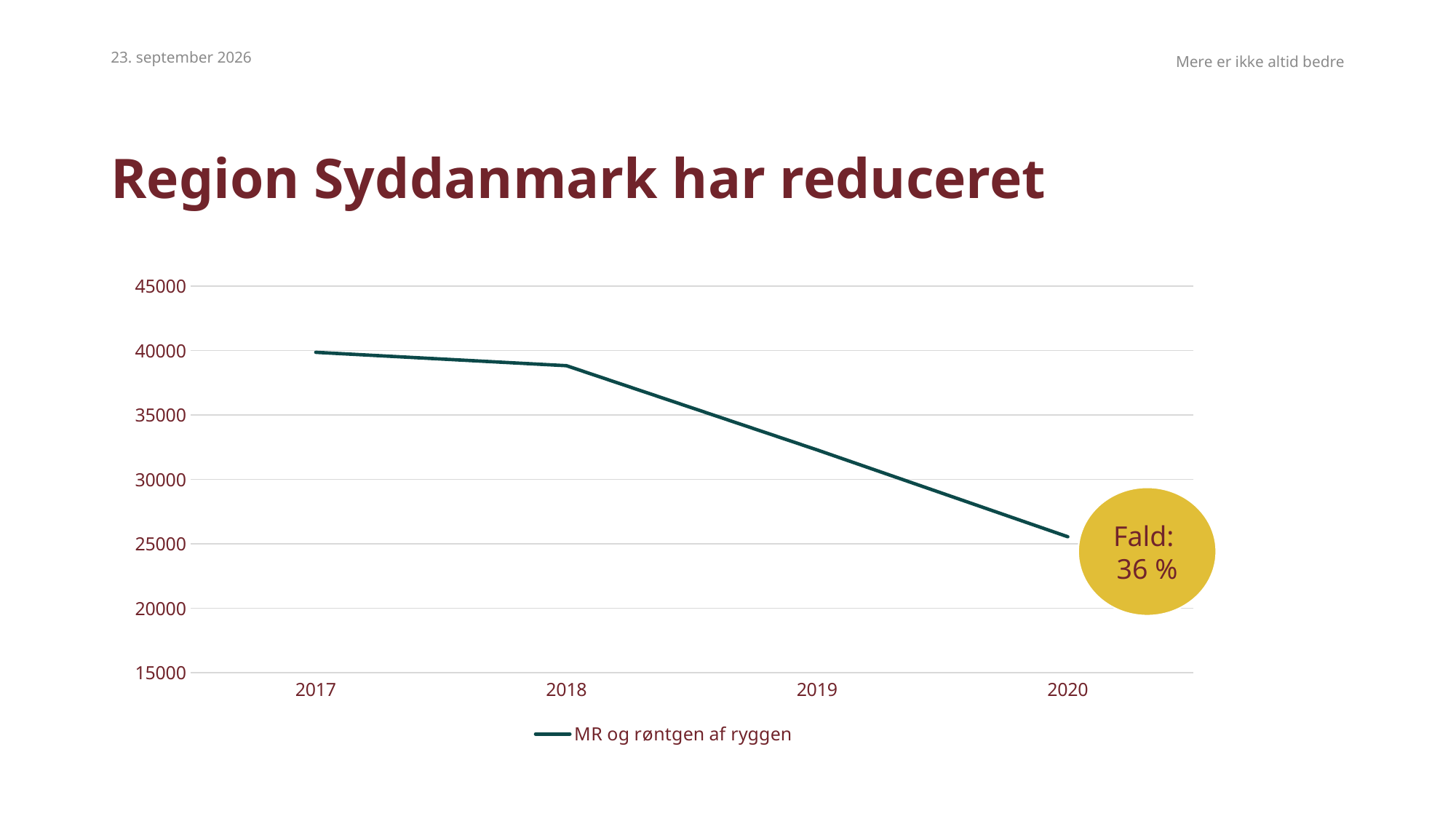
Which year has the lowest value? 2020 Is the value for 2017 greater or less than 35000? greater What percentage decline does the yellow circle on the chart state? 36 % Which year has the highest value? 2017 Is the value for 2020 greater or less than 30000? less How many years are shown on the x axis? 4 Do the values rise or fall from 2017 to 2020? fall Which is larger, the value for 2018 or the value for 2020? 2018 What is the name of the series shown in the legend? MR og røntgen af ryggen Is the value for 2019 greater or less than 35000? less What kind of chart is shown on the slide? line chart How many series does the legend list? 1